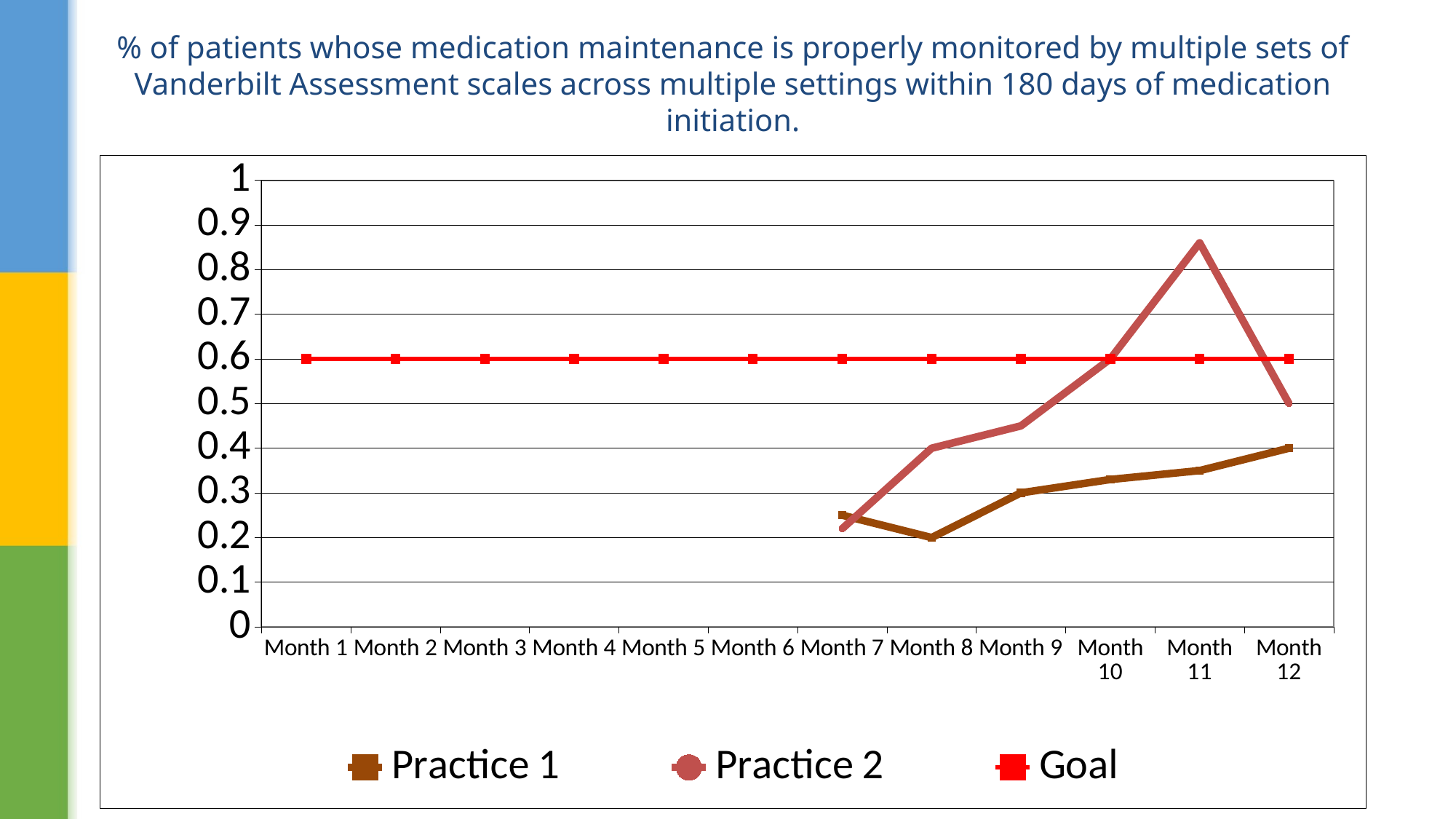
What is the value for Practice 2 in Month 12? 0.5 What kind of chart is shown on the slide? line chart How many series does the legend list? 3 Is the value for Practice 2 in Month 11 greater or less than 0.8? greater What is the value for Practice 1 in Month 12? 0.4 How many months are shown on the x axis? 12 Does the Practice 1 line rise or fall from Month 8 to Month 12? rise What is the value of the Goal line? 0.6 In which month does Practice 1 have its lowest value? Month 8 In which month does Practice 2 reach its highest value? Month 11 In Month 12, which series has the higher value, Practice 1 or Practice 2? Practice 2 What is the difference between Practice 2 and Practice 1 in Month 12? 0.1